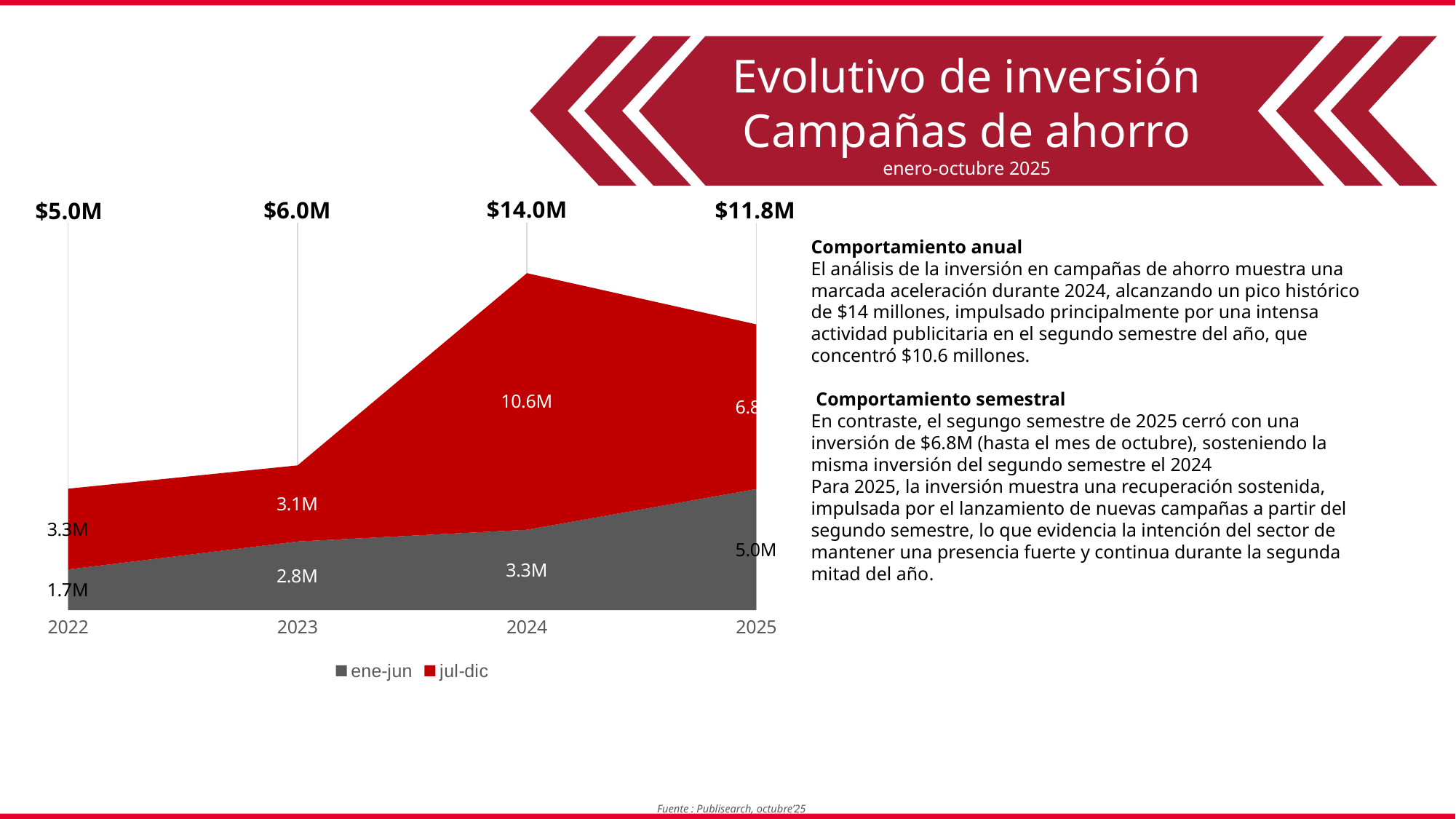
How many years are shown on the x axis? 4 How many series does the legend list? 2 What is the jul-dic value for 2023? 3.1M What is the ene-jun value for 2022? 1.7M What is the difference between the jul-dic value and the ene-jun value in 2024? 7.3M Which year has the highest jul-dic value? 2024 Which year has the lowest total investment? 2022 What is the ene-jun value for 2024? 3.3M Which year has the highest total investment? 2024 What kind of chart is shown on the slide? Area chart Which is larger in 2023, the ene-jun value or the jul-dic value? jul-dic What is the total investment shown above the chart for 2025? $11.8M